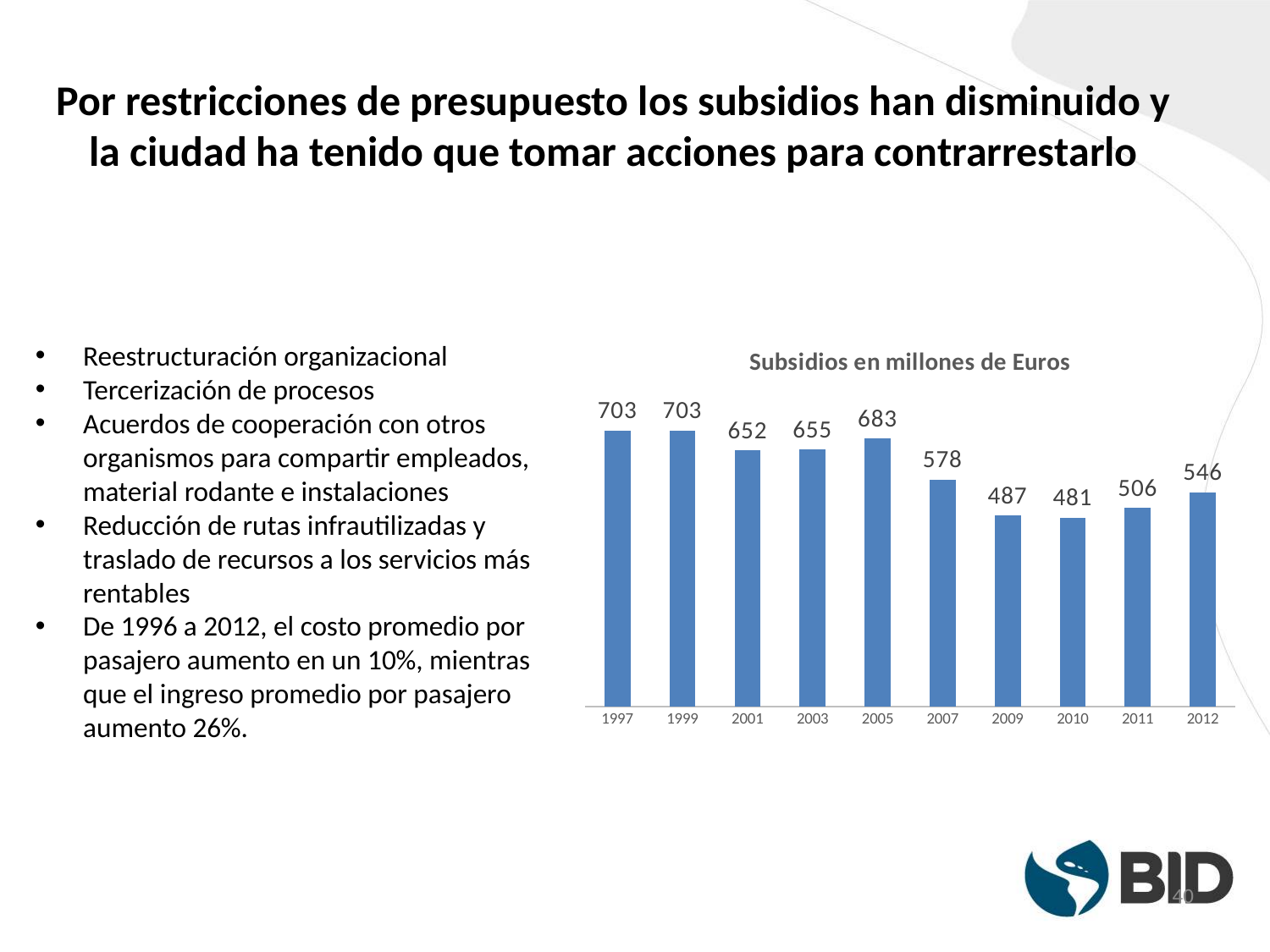
Which is larger, the subsidy value for 2009 or for 2011? 2011 What is the difference between the subsidy values for 2011 and 2012? 40 What is the highest subsidy value shown in the chart? 703 What is the difference between the subsidy values for 1997 and 2010? 222 What kind of chart is shown on the slide? Bar chart How many years are shown on the x axis of the chart? 10 What is the title of the chart? Subsidios en millones de Euros Which year has the lowest subsidy value? 2010 What is the subsidy value for 2005? 683 What is the subsidy value for 2007? 578 Which is larger, the subsidy value for 2001 or for 2003? 2003 What is the subsidy value for 2012? 546